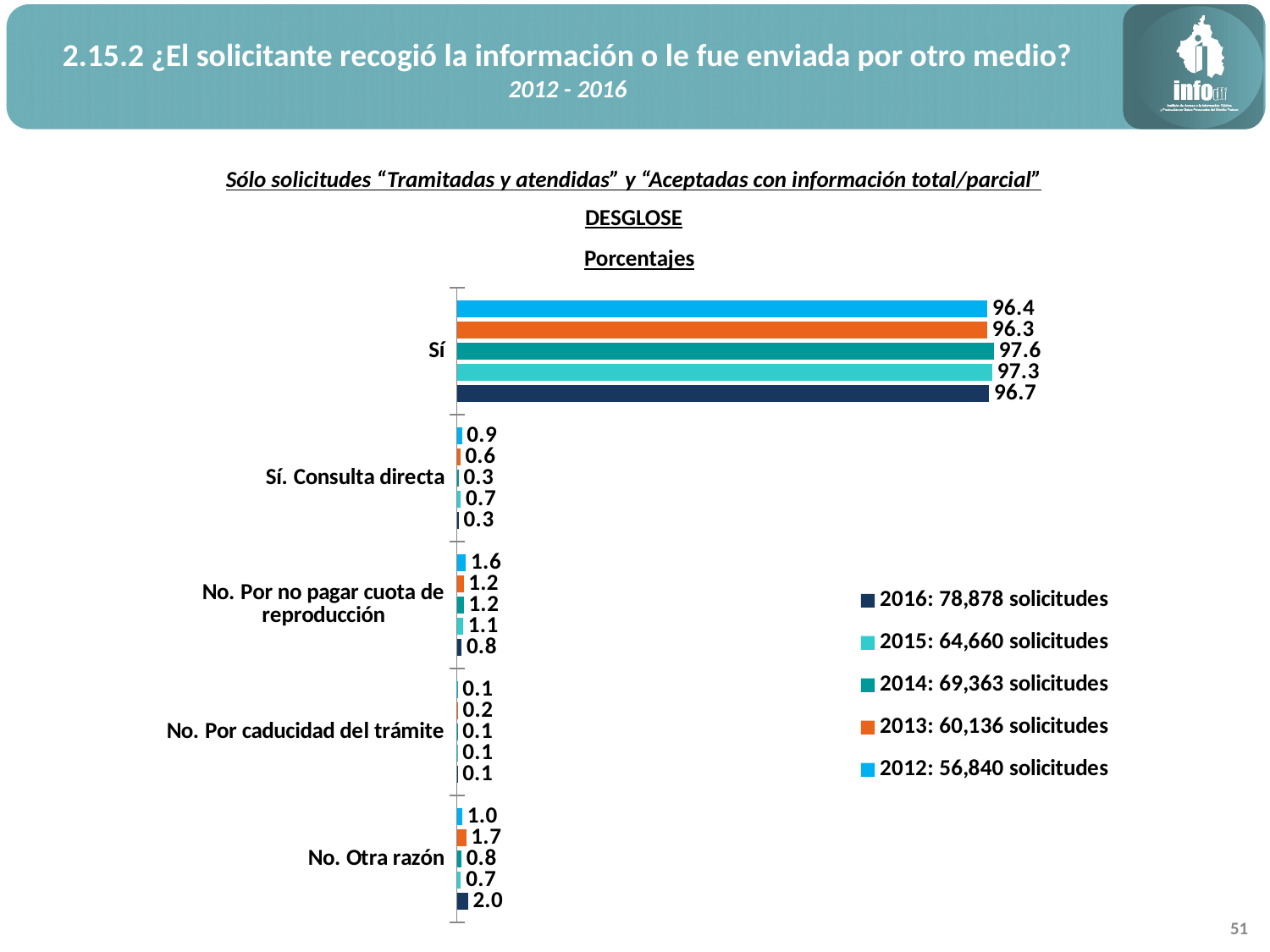
Which year has the lowest value for 'No. Por no pagar cuota de reproducción'? 2016 Which is larger for 'No. Otra razón': the 2013 value or the 2012 value? 2013 How many categories are shown on the vertical axis of the chart? 5 What is the difference between the 2014 and 2013 values for 'Sí'? 1.3 What kind of chart is shown on the slide? Bar chart What is the value for 'Sí. Consulta directa' in 2015? 0.7 How many series does the legend list? 5 What is the value for 'Sí' in 2014? 97.6 What is the value for 'No. Por no pagar cuota de reproducción' in 2012? 1.6 Which year has the highest value for 'Sí'? 2014 According to the legend, how many solicitudes were there in 2016? 78,878 solicitudes What is the value for 'No. Otra razón' in 2016? 2.0